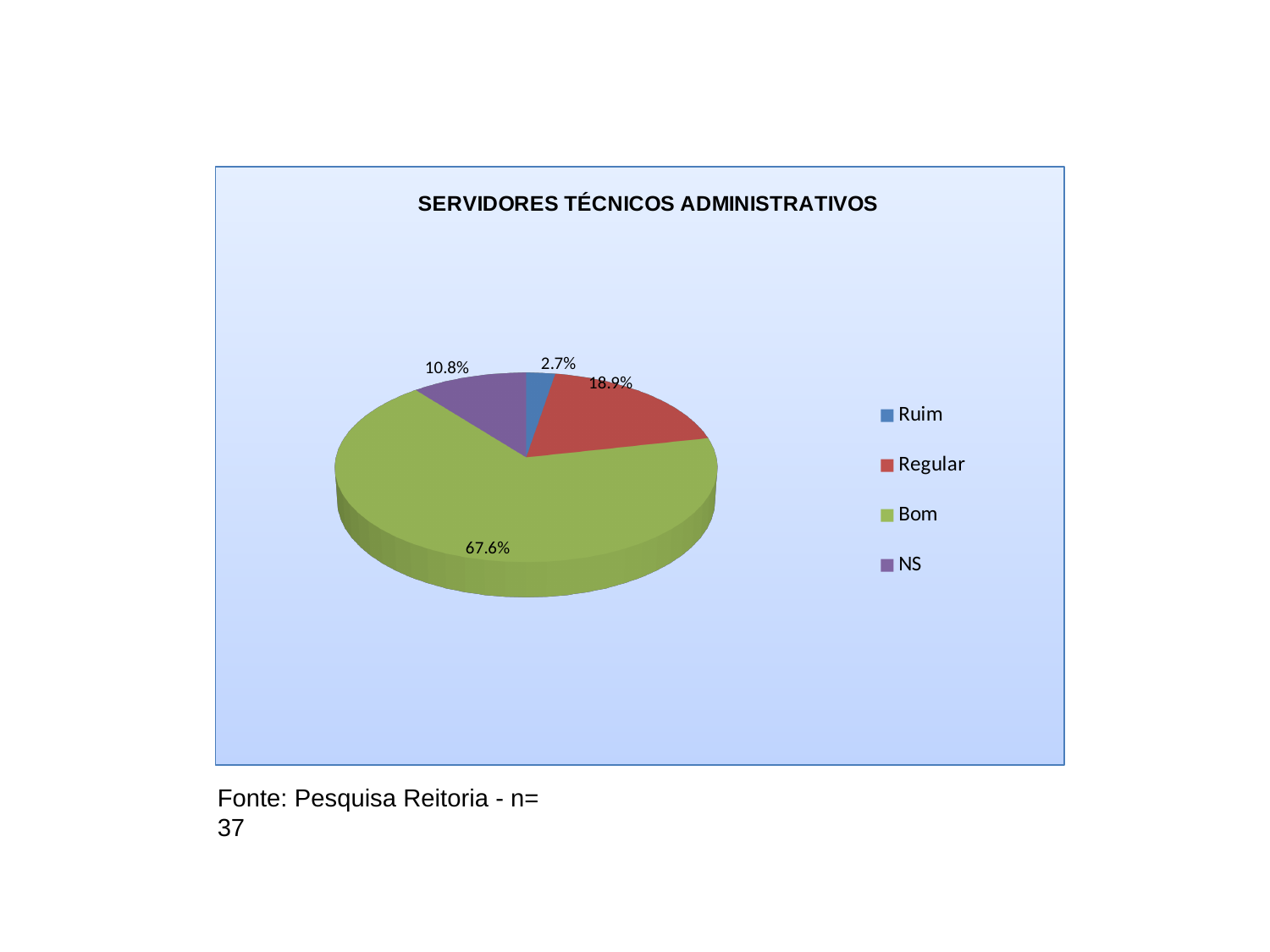
What percentage of the pie is the Bom slice? 67.6% How many categories does the legend list? 4 What percentage of the pie is the NS slice? 10.8% Which category has the smallest share of the pie? Ruim What is the title of the chart? SERVIDORES TÉCNICOS ADMINISTRATIVOS What colour is the Bom slice? green What is the difference in percentage points between the Bom slice and the Regular slice? 48.7 What kind of chart is shown on the slide? pie chart What percentage of the pie is the Ruim slice? 2.7% Which is larger, the Regular slice or the NS slice? Regular Which category has the largest share of the pie? Bom What percentage of the pie is the Regular slice? 18.9%